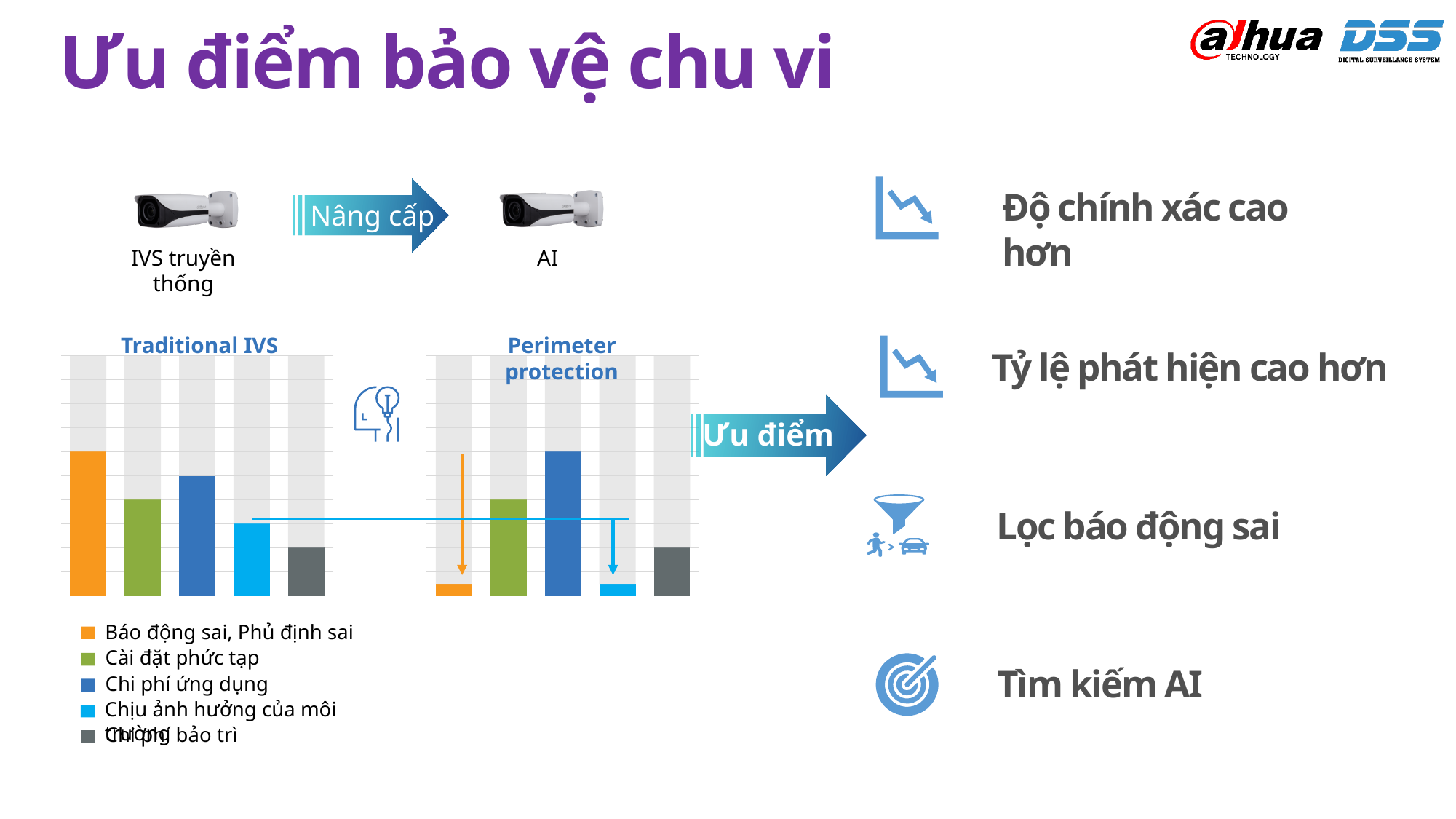
In the "Traditional IVS" chart, which category has the tallest bar? Báo động sai, Phủ định sai How many bars are shown in the "Traditional IVS" chart? 5 How many entries does the legend below the charts list? 5 In the "Traditional IVS" chart, which category has the shortest bar? Chi phí bảo trì What kind of chart is the "Traditional IVS" chart? bar chart In the "Perimeter protection" chart, which category has the tallest bar? Chi phí ứng dụng What is the title of the chart on the right? Perimeter protection In the "Perimeter protection" chart, which is taller: the bar for "Chi phí ứng dụng" or the bar for "Cài đặt phức tạp"? Chi phí ứng dụng How many bars are shown in the "Perimeter protection" chart? 5 Is the bar for "Báo động sai, Phủ định sai" taller in the "Traditional IVS" chart or in the "Perimeter protection" chart? Traditional IVS In the "Traditional IVS" chart, which is taller: the bar for "Báo động sai, Phủ định sai" or the bar for "Cài đặt phức tạp"? Báo động sai, Phủ định sai Which colour represents "Chi phí ứng dụng" in the legend? blue